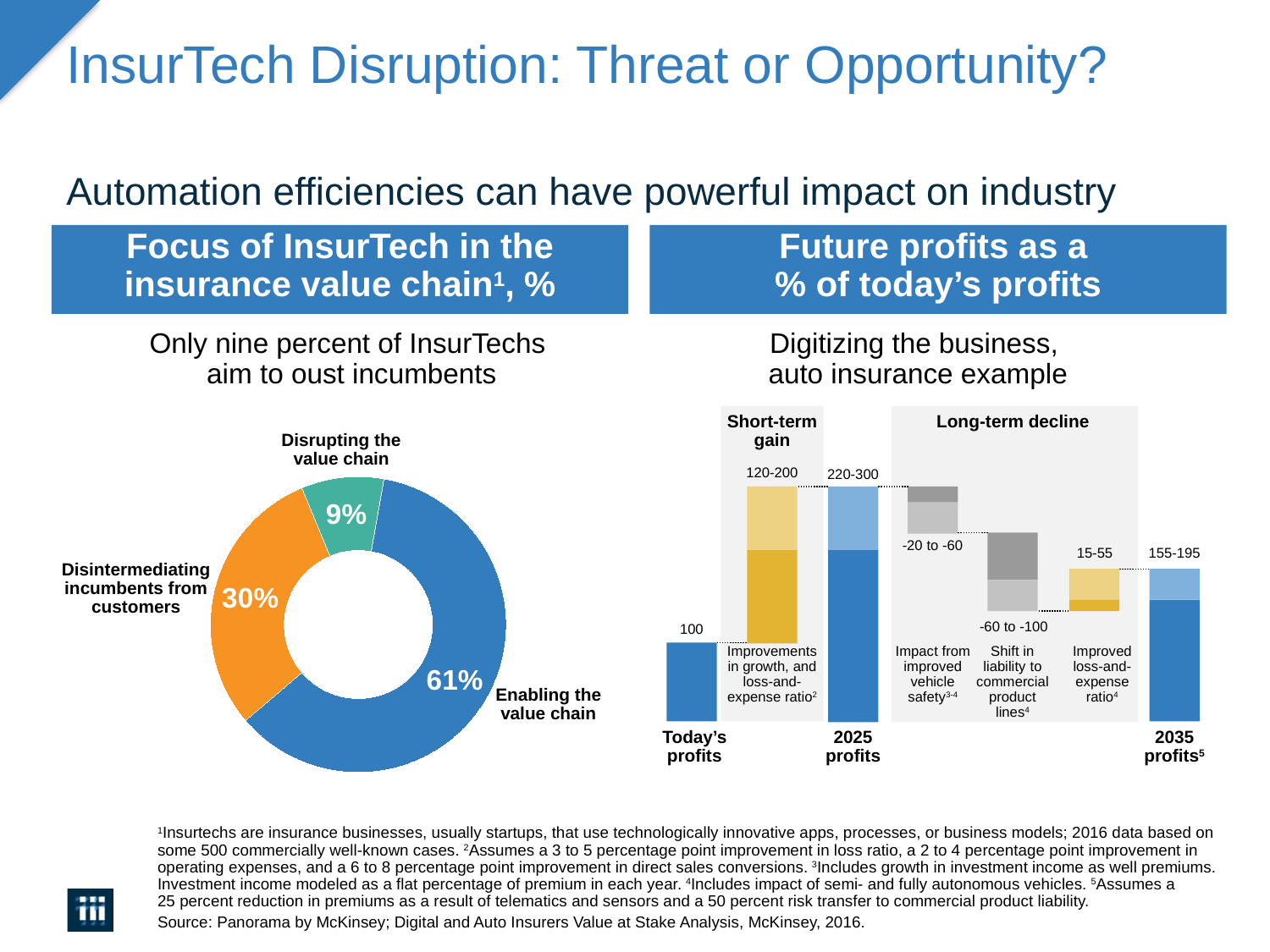
On the left chart (Focus of InsurTech in the insurance value chain), what share of InsurTechs focus on enabling the value chain? 61% On the left chart (Focus of InsurTech in the insurance value chain), what share of InsurTechs focus on disintermediating incumbents from customers? 30% On the left chart (Focus of InsurTech in the insurance value chain), which segment is the largest? Enabling the value chain On the left chart (Focus of InsurTech in the insurance value chain), which segment is the smallest? Disrupting the value chain On the right chart (Future profits as a % of today's profits), what value is shown for Today's profits? 100 What type of chart is the left chart (Focus of InsurTech in the insurance value chain)? Donut (pie) chart On the right chart (Future profits as a % of today's profits), what range is shown for the shift in liability to commercial product lines? -60 to -100 On the left chart (Focus of InsurTech in the insurance value chain), what share of InsurTechs focus on disrupting the value chain? 9% On the left chart (Focus of InsurTech in the insurance value chain), how many percentage points larger is the 'Enabling the value chain' segment than the 'Disintermediating incumbents from customers' segment? 31 percentage points On the right chart (Future profits as a % of today's profits), what range is shown for 2035 profits? 155-195 On the right chart (Future profits as a % of today's profits), what range is shown for 2025 profits? 220-300 On the left chart (Focus of InsurTech in the insurance value chain), how many segments does the chart have? 3